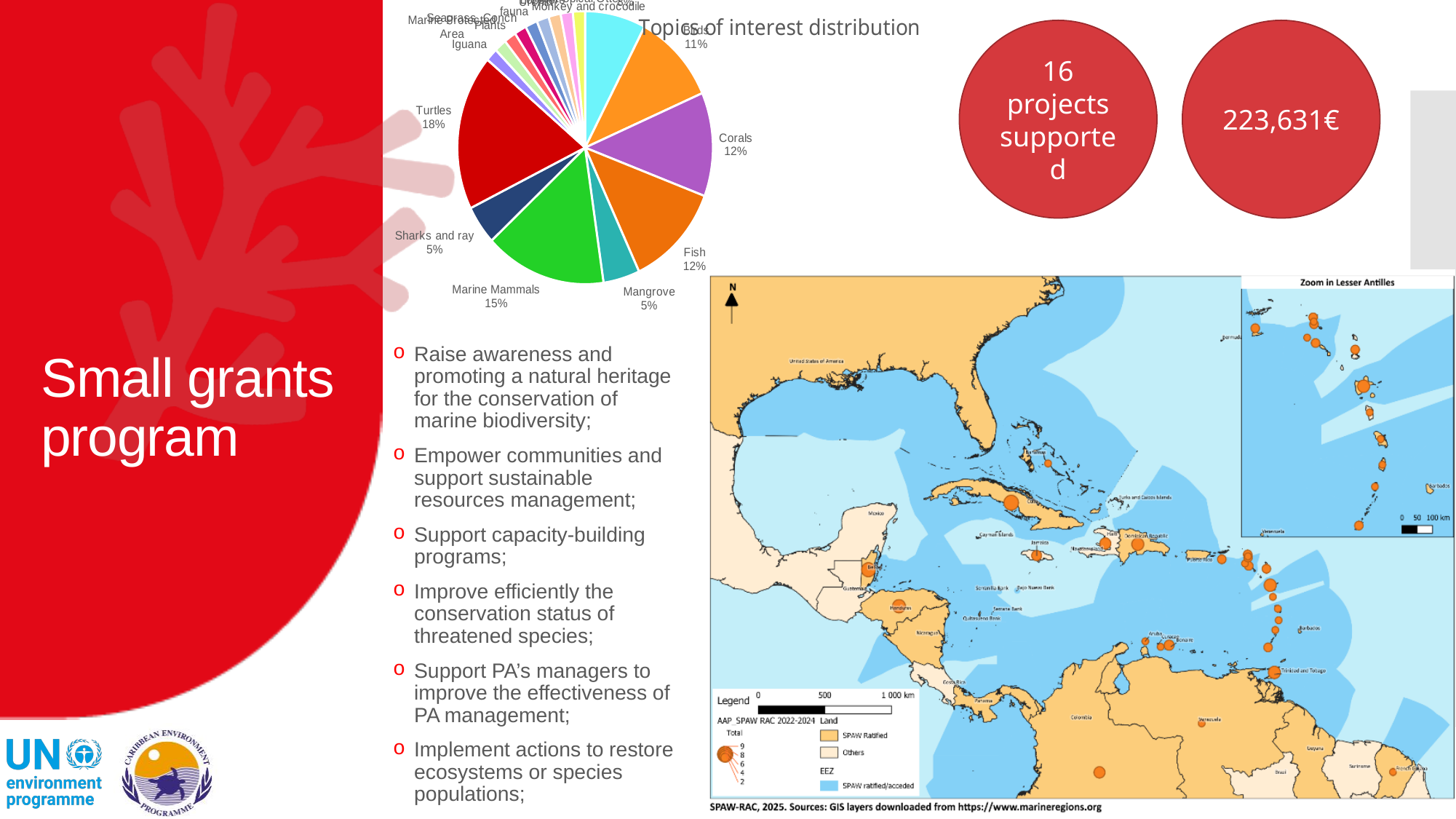
Which topic has the largest share of the pie chart? Turtles What percentage of the pie chart is Mangrove? 5% What type of chart is used to show the topics of interest distribution? pie chart How many percentage points larger is the Turtles share than the Marine Mammals share? 3 What percentage of the pie chart is Sharks and ray? 5% What percentage of the pie chart is Corals? 12% What percentage of the pie chart is Turtles? 18% What is the title of the pie chart? Topics of interest distribution What percentage of the pie chart is Marine Mammals? 15% Which has a larger share of the pie chart, Fish or Mangrove? Fish What percentage of the pie chart is Fish? 12% Which has a larger share of the pie chart, Marine Mammals or Corals? Marine Mammals